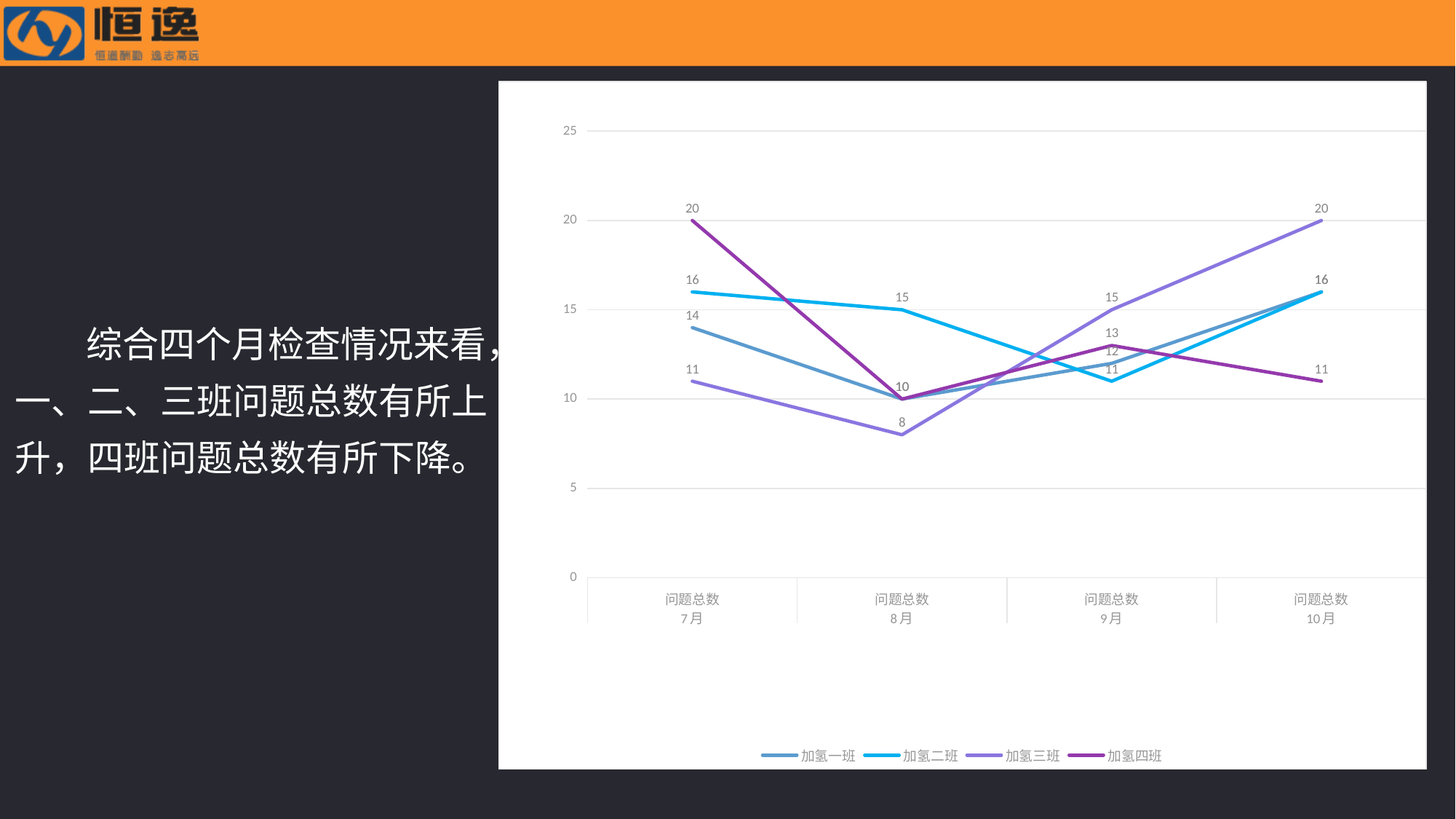
How many series does the legend list? 4 What kind of chart is shown on the slide? line chart Which series has the highest value in 7月? 加氢四班 What is the value for 加氢三班 in 8月? 8 What is the difference between 加氢三班 and 加氢四班 in 10月? 9 What is the value for 加氢三班 in 10月? 20 What is the value for 加氢二班 in 9月? 11 How many months (categories) are plotted along the x axis? 4 Does the value for 加氢三班 rise or fall from 8月 to 10月? rise What is the value for 加氢四班 in 7月? 20 Which series has the lowest value in 8月? 加氢三班 In 9月, which is larger: the value for 加氢三班 or the value for 加氢一班? 加氢三班